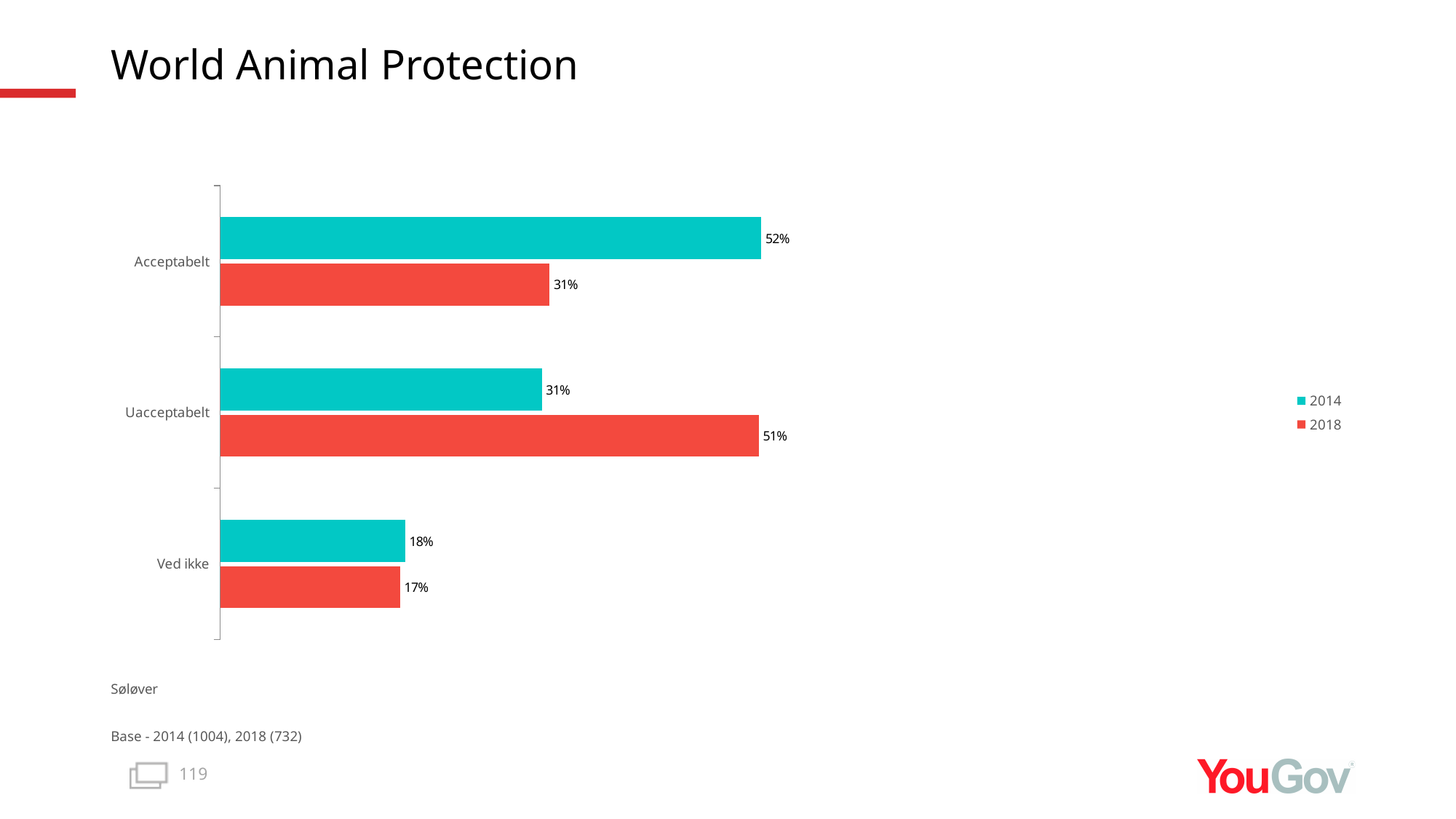
Which is larger for Uacceptabelt, the 2014 value or the 2018 value? 2018 What is the 2014 value for Uacceptabelt? 31% What kind of chart is shown on the slide? Bar chart Which category has the highest 2014 value? Acceptabelt How many categories are shown on the chart? 3 How many series does the legend list? 2 What is the 2018 value for Ved ikke? 17% Which colour represents the 2018 series? Red What is the 2018 value for Uacceptabelt? 51% What is the 2014 value for Acceptabelt? 52% Which category has the lowest 2018 value? Ved ikke What is the difference between the 2014 and 2018 values for Acceptabelt? 21 percentage points